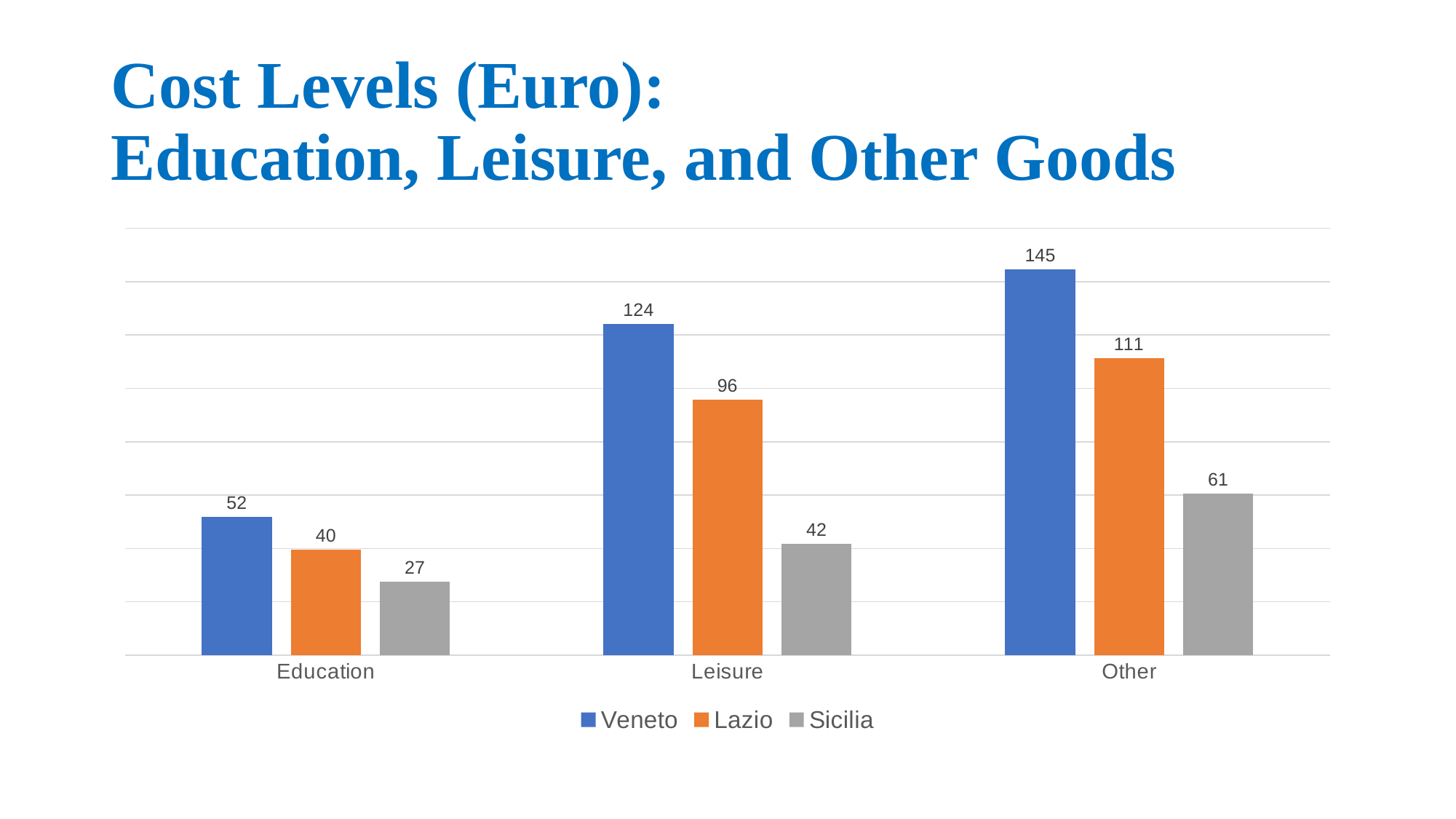
What is the value for Lazio in the Other category? 111 Which category has the lowest value for Sicilia? Education What is the value for Sicilia in the Leisure category? 42 What kind of chart is shown on the slide? Bar chart What is the value for Veneto in the Education category? 52 Which is larger: the Lazio value for Other or the Veneto value for Leisure? Veneto value for Leisure How many series does the legend list? 3 Do the Lazio values rise or fall from Education to Other along the x axis? Rise How many categories are shown on the x axis? 3 Which category has the highest value for Veneto? Other What is the difference between the Veneto and Lazio values in the Leisure category? 28 Which series is shown in orange in the legend? Lazio